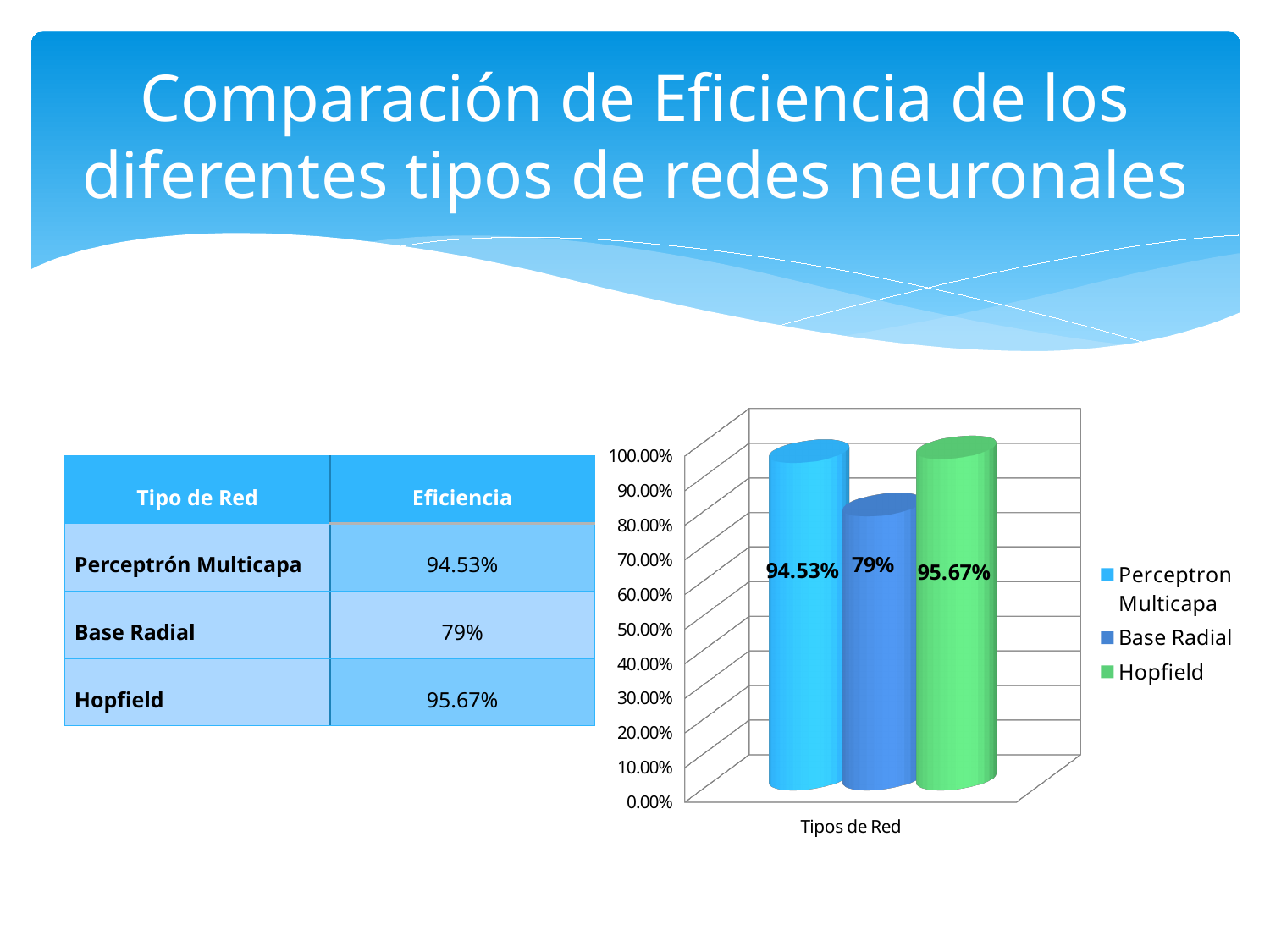
Is the value for Base Radial greater or less than 90.00%? less What kind of chart is shown on the slide? Bar chart What is the value shown for Base Radial in the chart? 79% What is the difference between the Perceptron Multicapa value and the Base Radial value? 15.53% What is the value shown for Hopfield in the chart? 95.67% How many series does the chart legend list? 3 What is the label on the horizontal axis of the chart? Tipos de Red Which is larger, the value for Perceptron Multicapa or the value for Base Radial? Perceptron Multicapa Which series has the highest value in the chart? Hopfield Which series has the lowest value in the chart? Base Radial What is the value shown for Perceptron Multicapa in the chart? 94.53% What is the difference between the Hopfield value and the Base Radial value? 16.67%